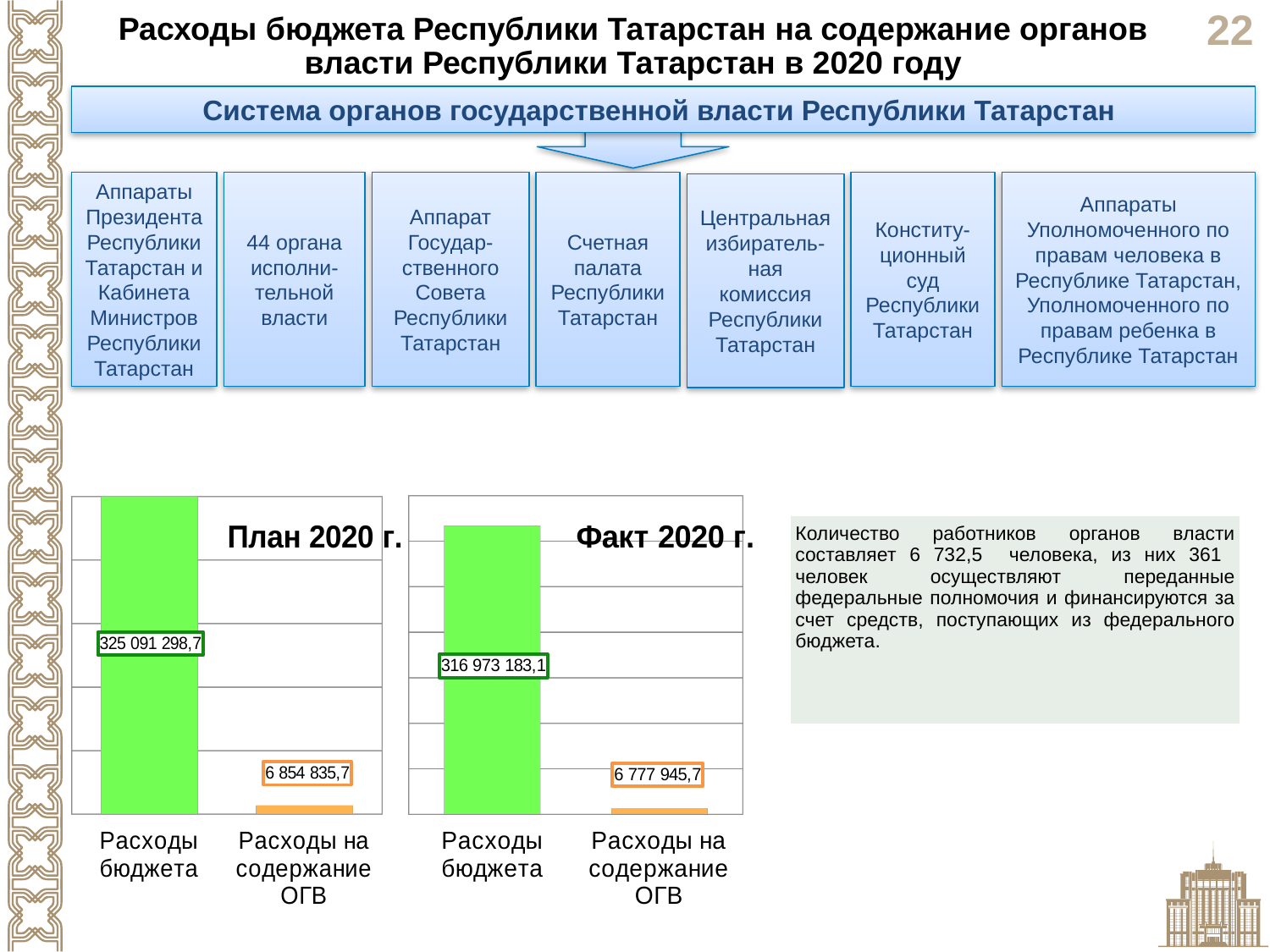
In the "План 2020 г." chart, which category has the highest value? Расходы бюджета How many categories are shown in the "Факт 2020 г." chart? 2 In the "Факт 2020 г." chart, what is the value for Расходы бюджета? 316 973 183,1 In the "Факт 2020 г." chart, what is the value for Расходы на содержание ОГВ? 6 777 945,7 In the "Факт 2020 г." chart, what is the difference between Расходы бюджета and Расходы на содержание ОГВ? 310 195 237,4 What kind of chart is the "План 2020 г." chart? bar chart In the "Факт 2020 г." chart, what colour is the bar for Расходы бюджета? green In the "План 2020 г." chart, what is the difference between Расходы бюджета and Расходы на содержание ОГВ? 318 236 463,0 In the "План 2020 г." chart, what is the value for Расходы на содержание ОГВ? 6 854 835,7 Is the value for Расходы бюджета larger in the "План 2020 г." chart or in the "Факт 2020 г." chart? План 2020 г. In the "План 2020 г." chart, what is the value for Расходы бюджета? 325 091 298,7 In the "Факт 2020 г." chart, which category has the lowest value? Расходы на содержание ОГВ